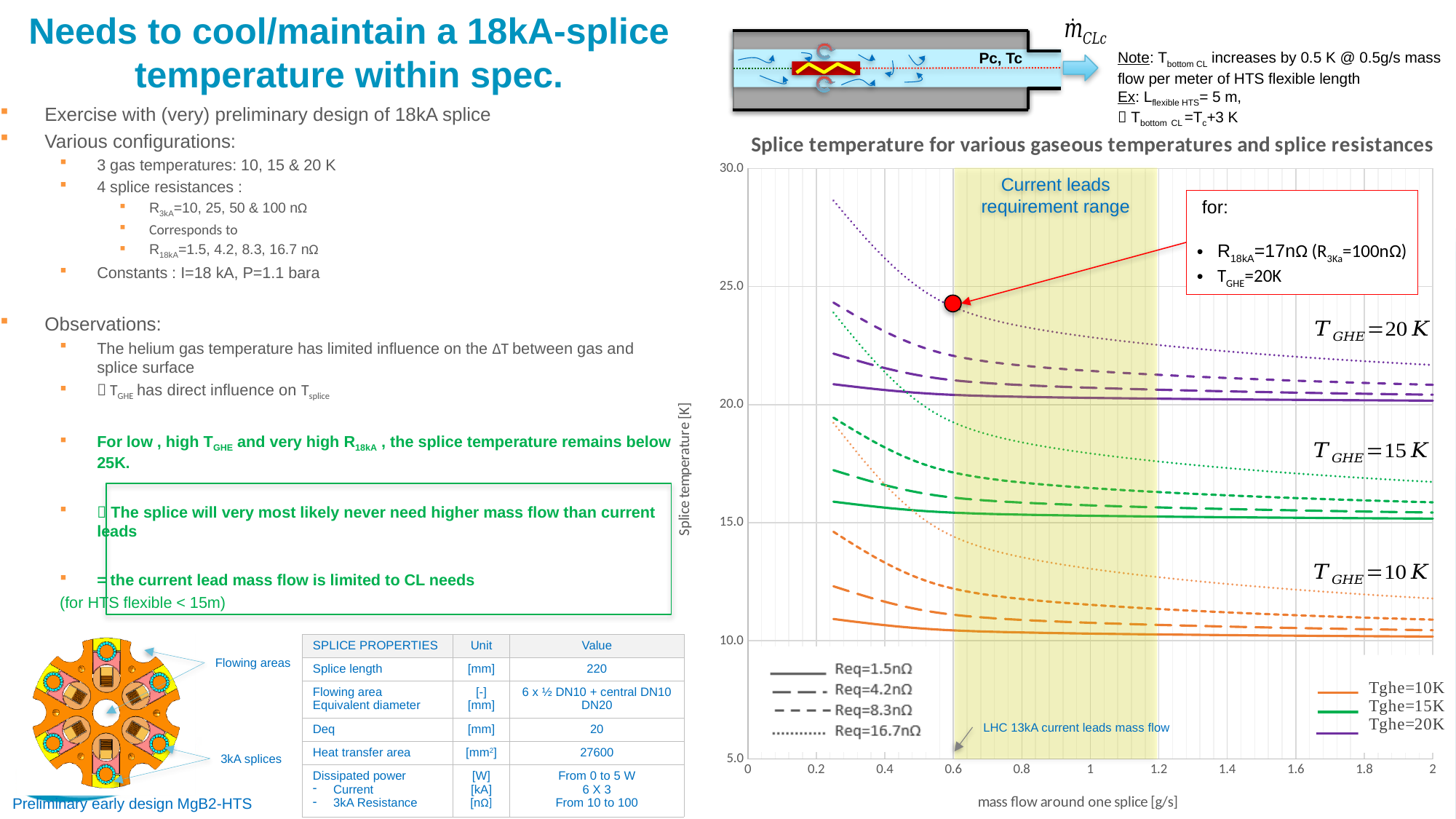
Which gas temperature group (Tghe) has the highest splice temperatures on the chart? Tghe=20K Is the splice temperature for Tghe=10K with Req=1.5nΩ at a mass flow of 2 g/s greater or less than 15.0 K? less What is the title of the chart? Splice temperature for various gaseous temperatures and splice resistances Which splice resistance (Req) gives the highest splice temperature within each gas temperature group? Req=16.7nΩ Is the splice temperature for Tghe=20K with Req=16.7nΩ at a mass flow of 0.4 g/s greater or less than 25.0 K? greater Is the splice temperature for Tghe=15K with Req=1.5nΩ at a mass flow of 1 g/s greater or less than 20.0 K? less At a mass flow of 1 g/s, which is higher: the Tghe=20K Req=1.5nΩ curve or the Tghe=10K Req=1.5nΩ curve? Tghe=20K Req=1.5nΩ What is the label of the x axis of the chart? mass flow around one splice [g/s] As mass flow increases along the x axis, do the splice temperature curves rise or fall? fall How many splice resistance values (Req) does the chart legend list? 4 What kind of chart is shown on the right of the slide? line chart How many gas temperatures (Tghe) does the chart legend list? 3